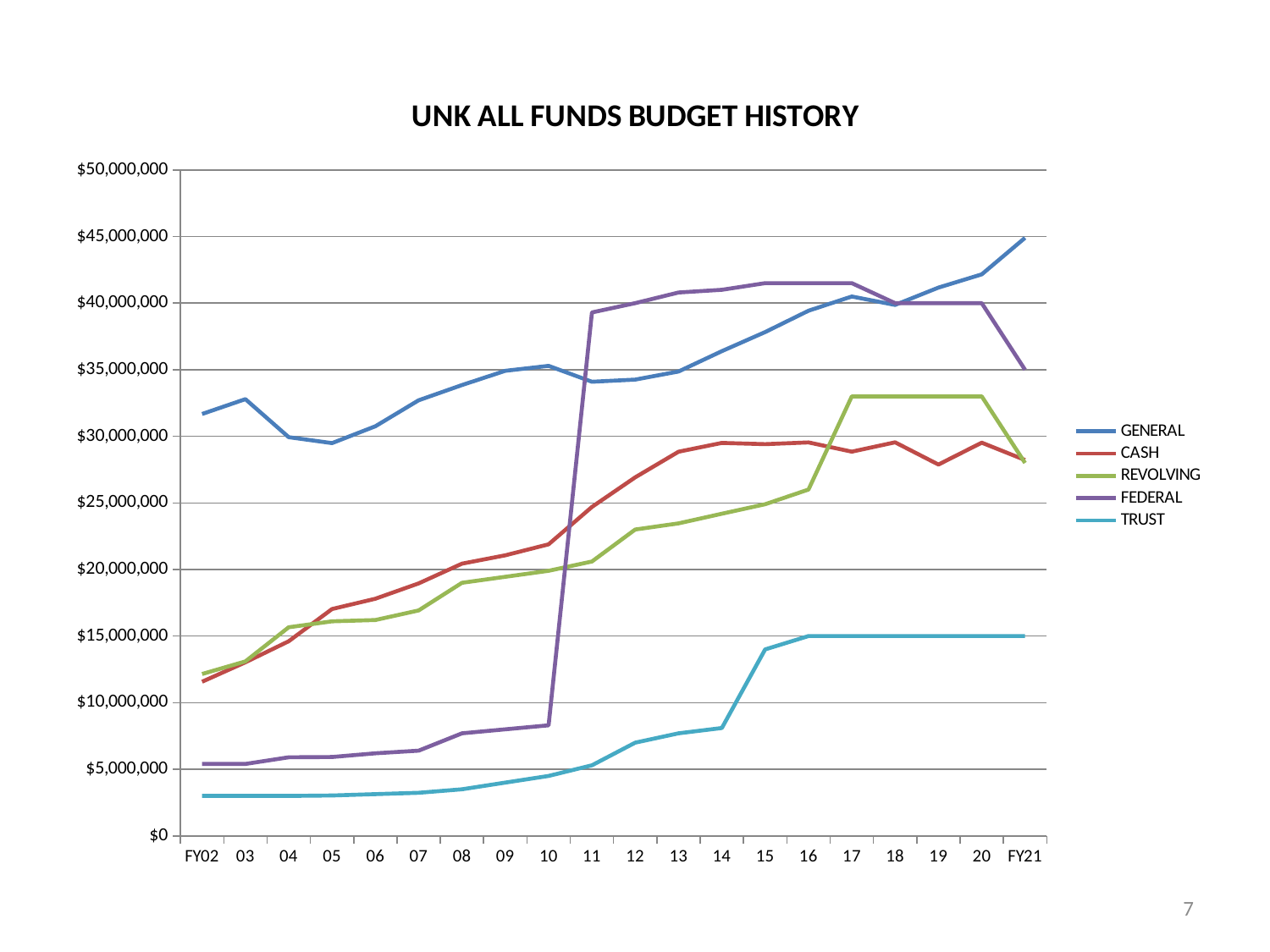
Is the value for FEDERAL at FY02 greater or less than $10,000,000? less Which series has the lowest value at FY02? TRUST At FY17, which is larger, REVOLVING or CASH? REVOLVING At FY11, which is larger, FEDERAL or GENERAL? FEDERAL Does the TRUST series rise or fall from FY02 to FY21? rise What is the title of the chart? UNK ALL FUNDS BUDGET HISTORY How many series does the legend list? 5 Is the value for GENERAL at FY21 greater or less than $40,000,000? greater What is the value for TRUST at FY21? $15,000,000 How many fiscal years are plotted along the x axis? 20 What kind of chart is shown on the slide? line chart Which series has the highest value at FY21? GENERAL